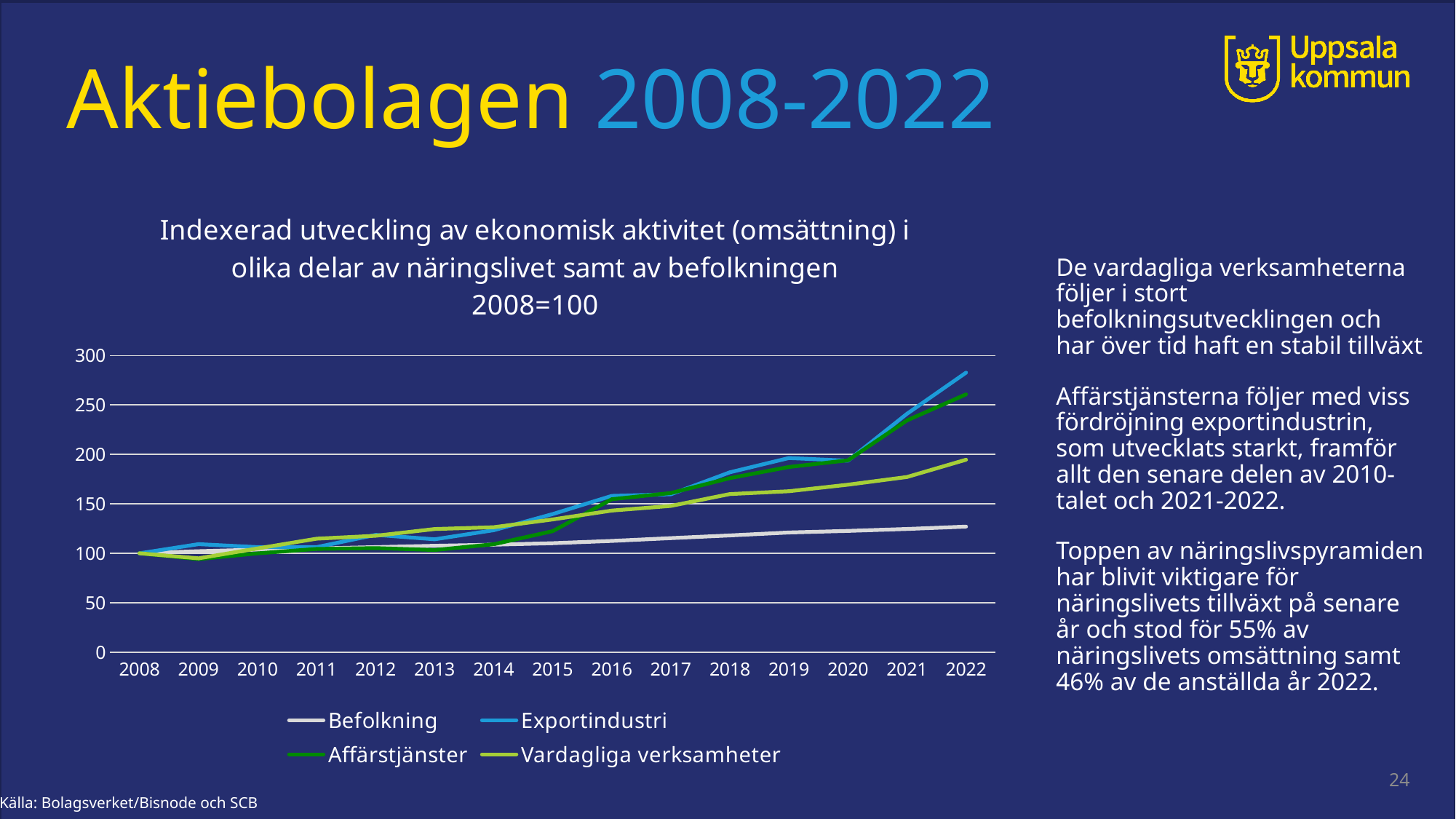
Which series is drawn with a blue line in the chart? Exportindustri Is the value for Befolkning in 2022 greater or less than 150? less What kind of chart is shown on the slide? line chart Which is larger in 2022, the value for Exportindustri or the value for Befolkning? Exportindustri How many series does the chart legend list? 4 Which series has the lowest value in 2022? Befolkning How many years are shown on the x axis of the chart? 15 Is the value for Exportindustri in 2022 greater or less than 250? greater Which series has the highest value in 2022? Exportindustri What is the index value for all series in 2008? 100 Does the Befolkning series rise or fall from 2008 to 2022? rise Is the value for Exportindustri in 2016 greater or less than 150? greater